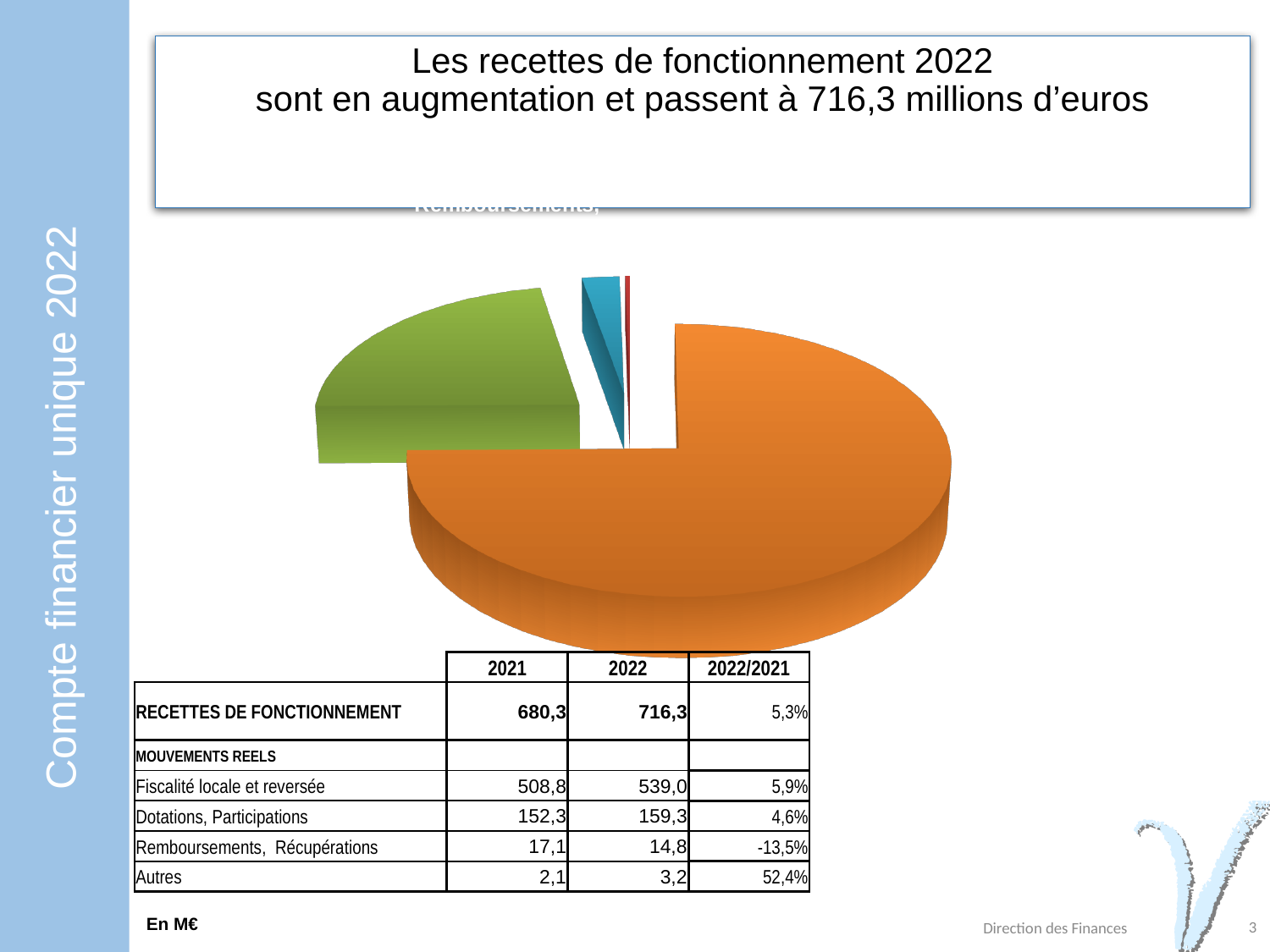
How many slices does the pie chart have? 4 Which colour slice is the smallest in the pie chart? red In the pie chart, which is larger, the green slice or the blue slice? green What kind of chart is shown on the slide? pie chart Is the pie chart drawn in 3D or flat 2D? 3D In the pie chart, which is larger, the orange slice or the green slice? orange Which colour slice is the largest in the pie chart? orange Does the orange slice represent more or less than half of the pie chart? more